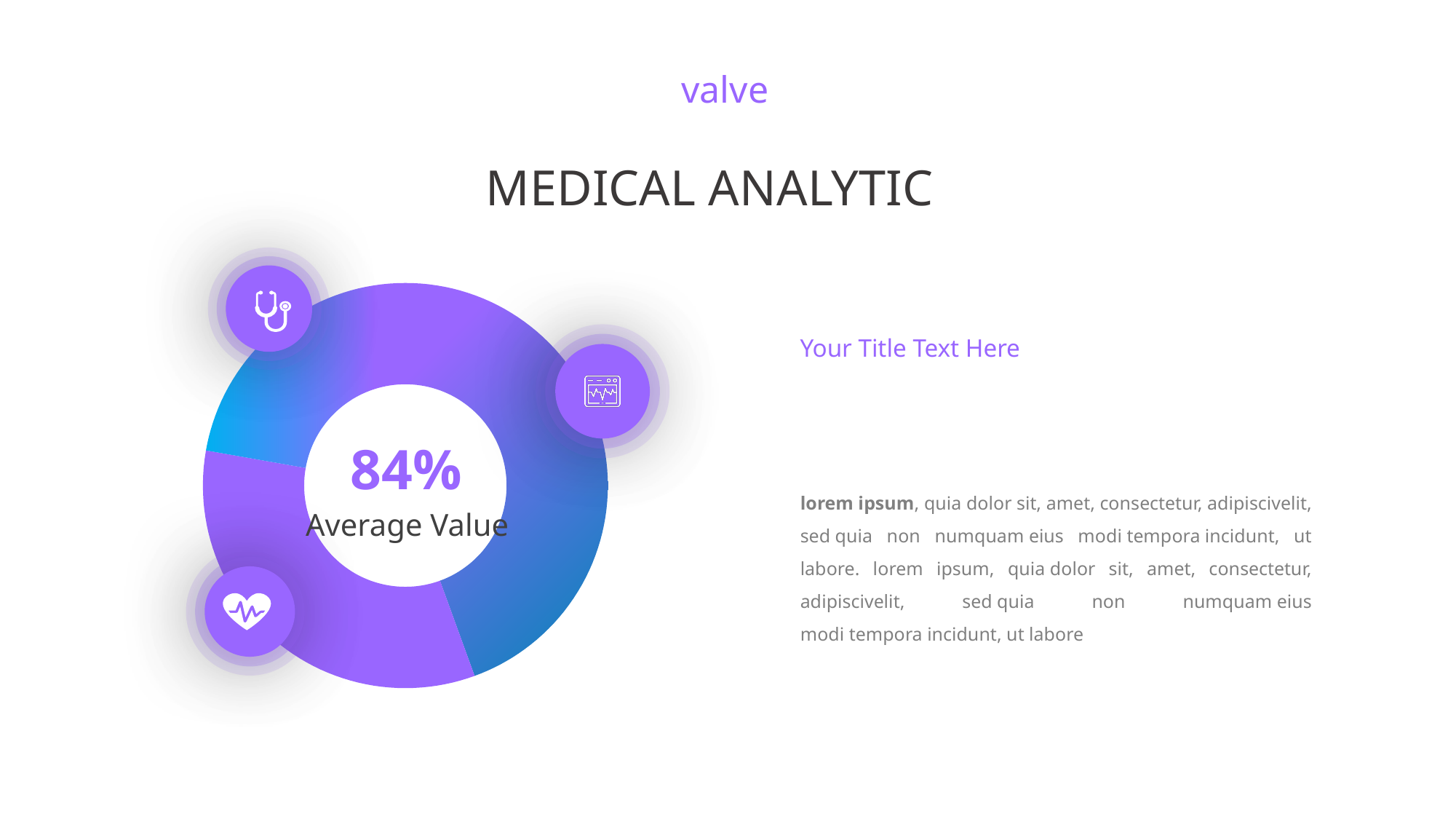
Is the Average Value shown in the donut chart greater or less than 80%? greater What kind of chart is shown on the slide? donut chart What value is printed in the centre of the donut chart? 84% What does the 84% in the centre of the donut chart represent, according to the label beneath it? Average Value What is the title of the slide containing the donut chart? MEDICAL ANALYTIC